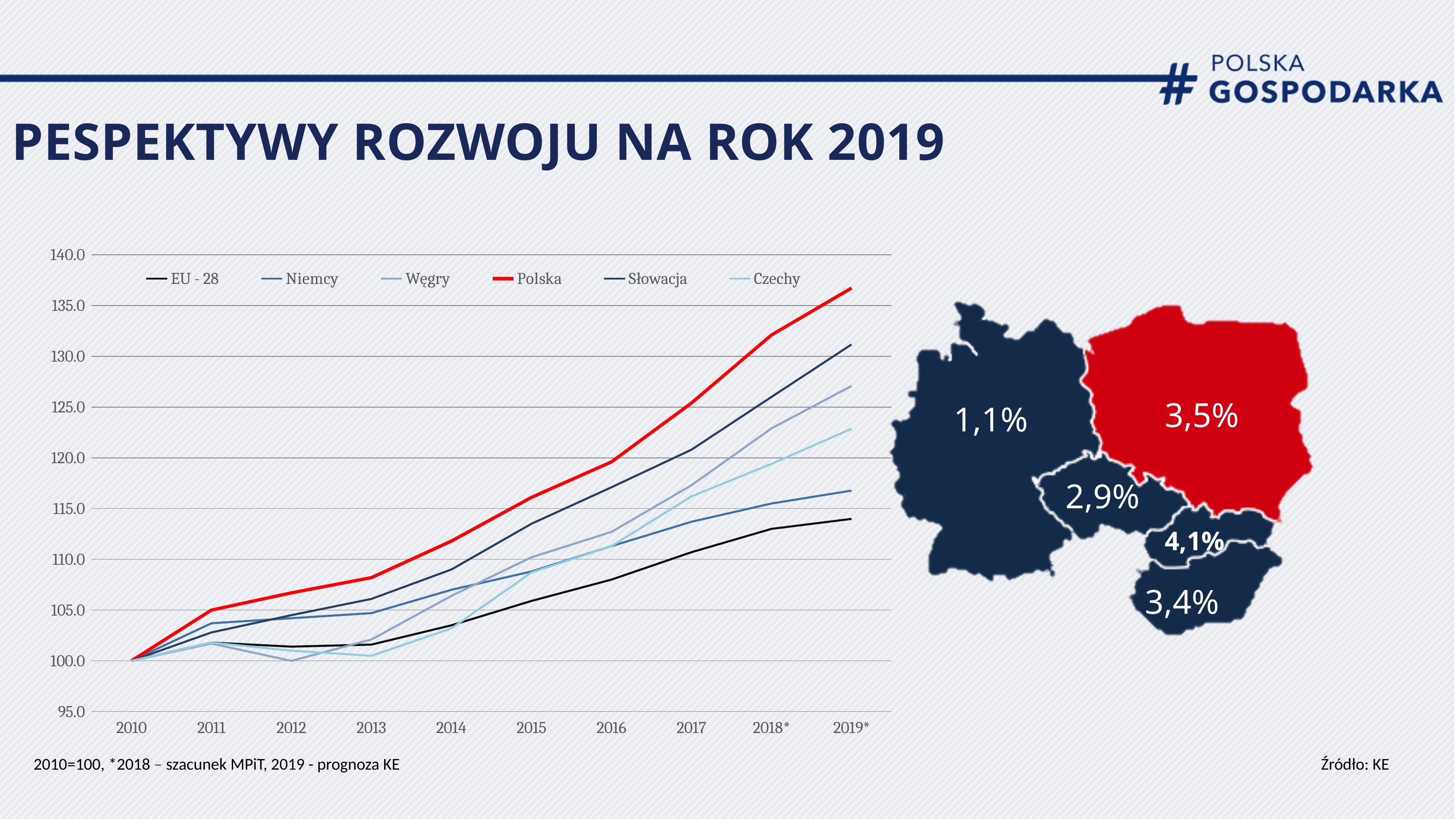
Does the Polska line rise or fall from 2010 to 2019*? rise Which series has the highest value in 2019* on the line chart? Polska Which series has the lowest value in 2019* on the line chart? EU - 28 What kind of chart is shown on the left of the slide? line chart Is the value for Niemcy in 2019* greater or less than 115? greater How many series does the legend of the line chart list? 6 Is the value for Polska in 2019* greater or less than 135? greater Is the value for EU - 28 in 2019* greater or less than 115? less In 2019*, which series has the larger value, Czechy or Niemcy? Czechy How many years are shown on the x axis of the line chart? 10 In 2019*, which series has the larger value, Słowacja or Węgry? Słowacja What colour is the Polska line on the chart? red